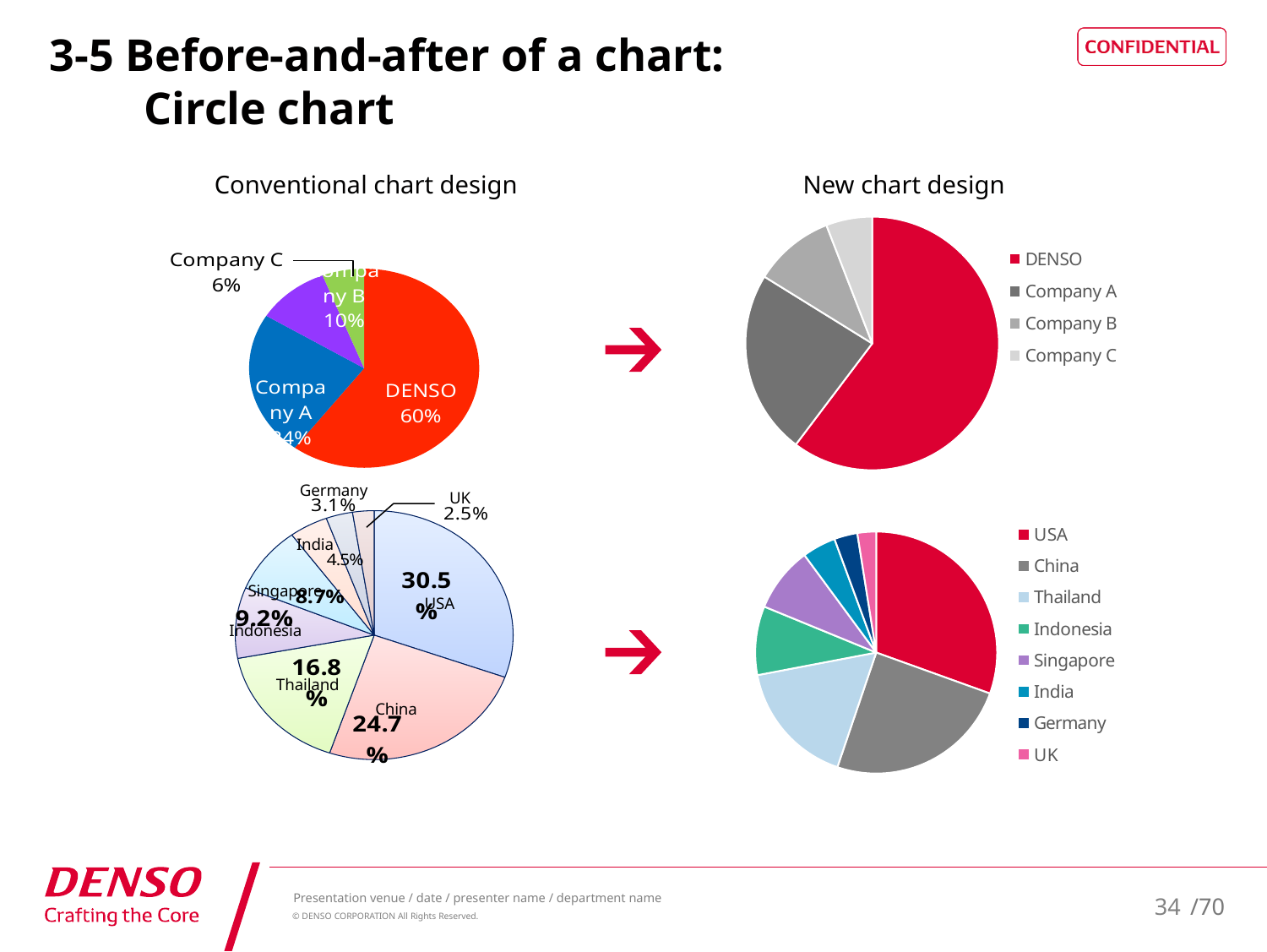
In the top-left conventional pie chart, which category has the largest share? DENSO In the top-left conventional pie chart, how many percentage points larger is DENSO's share than Company B's? 50 percentage points In the top-left conventional pie chart, what share is shown for Company C? 6% In the top-left conventional pie chart, what share is shown for DENSO? 60% In the top-left conventional pie chart, what share is shown for Company B? 10% In the bottom-left conventional pie chart, which country has the smallest share? UK In the bottom-left conventional pie chart, which has the larger share, Germany or India? India What kind of chart is the top-right new-design chart? Pie chart In the bottom-left conventional pie chart, what share is shown for Thailand? 16.8% How many entries does the legend of the bottom-right new-design chart list? 8 In the bottom-left conventional pie chart, what share is shown for China? 24.7% In the bottom-left conventional pie chart, what share is shown for USA? 30.5%